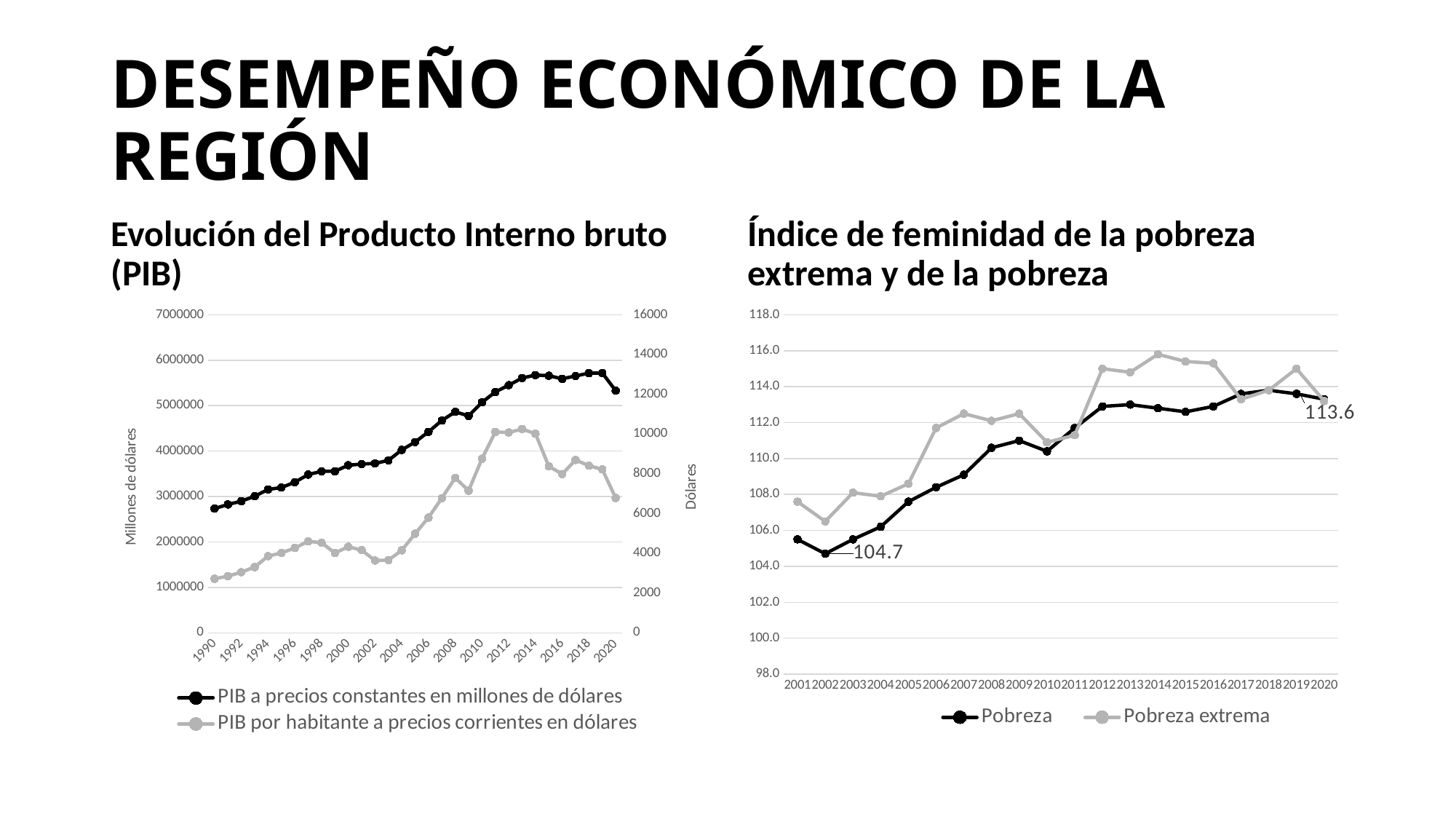
In the 'Índice de feminidad de la pobreza extrema y de la pobreza' chart, which series has the higher value in 2006, Pobreza or Pobreza extrema? Pobreza extrema What kind of chart is the 'Evolución del Producto Interno bruto (PIB)' chart? line chart How many series does the legend of the 'Evolución del Producto Interno bruto (PIB)' chart list? 2 How many series does the legend of the 'Índice de feminidad de la pobreza extrema y de la pobreza' chart list? 2 In the 'Índice de feminidad de la pobreza extrema y de la pobreza' chart, is the value for Pobreza extrema in 2014 greater or less than 114.0? greater In the 'Evolución del Producto Interno bruto (PIB)' chart, is the value for 'PIB por habitante a precios corrientes en dólares' in 2020 greater or less than 8000? less In the 'Índice de feminidad de la pobreza extrema y de la pobreza' chart, what is the value of Pobreza in 2002? 104.7 In the 'Índice de feminidad de la pobreza extrema y de la pobreza' chart, how many years are shown on the x axis? 20 In the 'Índice de feminidad de la pobreza extrema y de la pobreza' chart, does the Pobreza series generally rise or fall from 2001 to 2020? rise In the 'Índice de feminidad de la pobreza extrema y de la pobreza' chart, in which year is the Pobreza series lowest? 2002